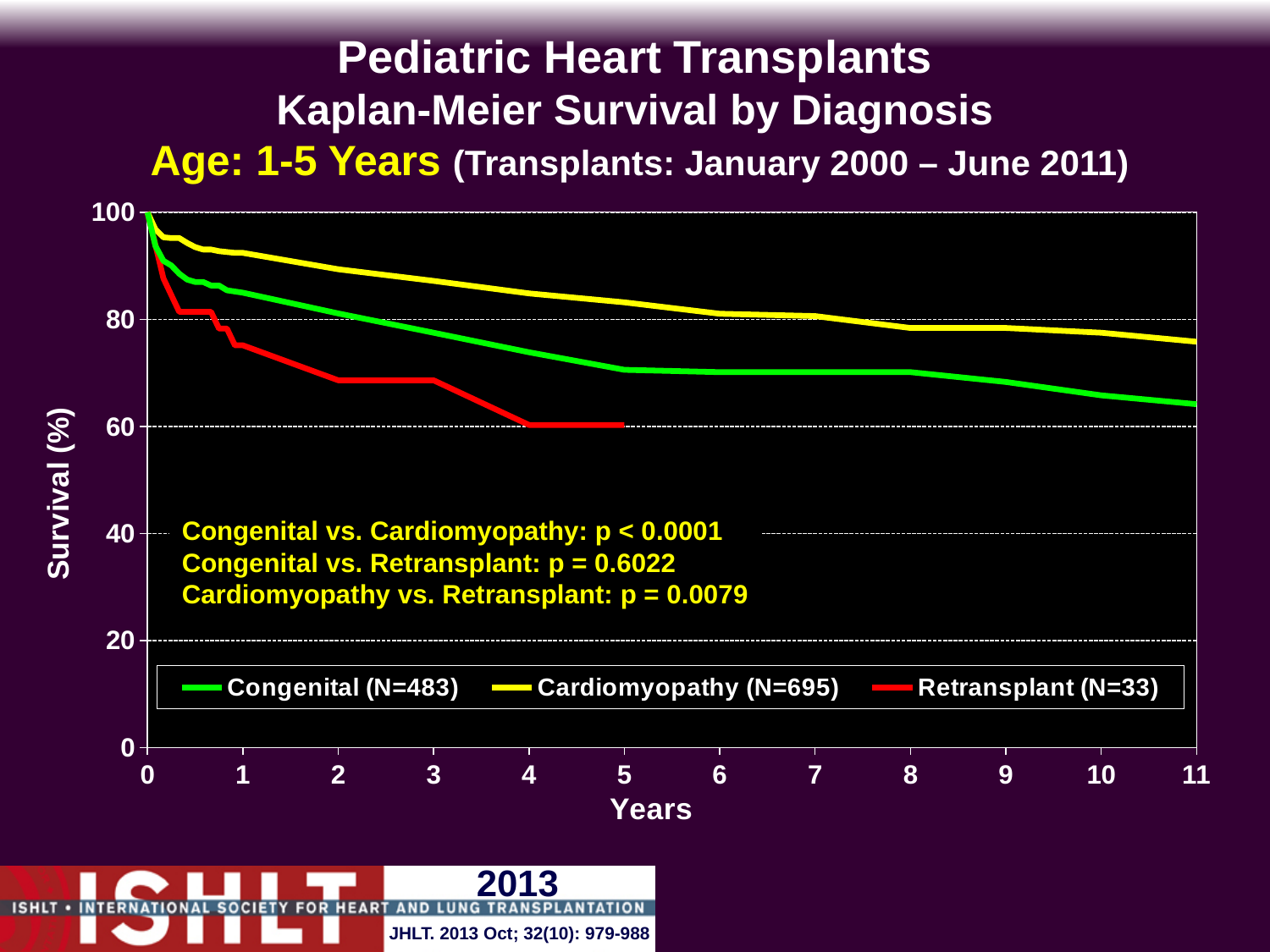
Is the survival for Retransplant at 3 years greater or less than 60? greater Is the survival for Cardiomyopathy at 5 years greater or less than 80? greater Is the survival for Congenital at 5 years greater or less than 80? less What kind of chart is shown on the slide? line chart What is the N for the Retransplant group shown in the legend? 33 Which diagnosis group has the lowest survival at 3 years? Retransplant Which diagnosis group has the highest survival at 3 years? Cardiomyopathy Do the survival curves rise or fall as years increase? fall What p-value is shown for Congenital vs. Cardiomyopathy? p < 0.0001 At 5 years, which has higher survival: Congenital or Cardiomyopathy? Cardiomyopathy How many series does the legend list? 3